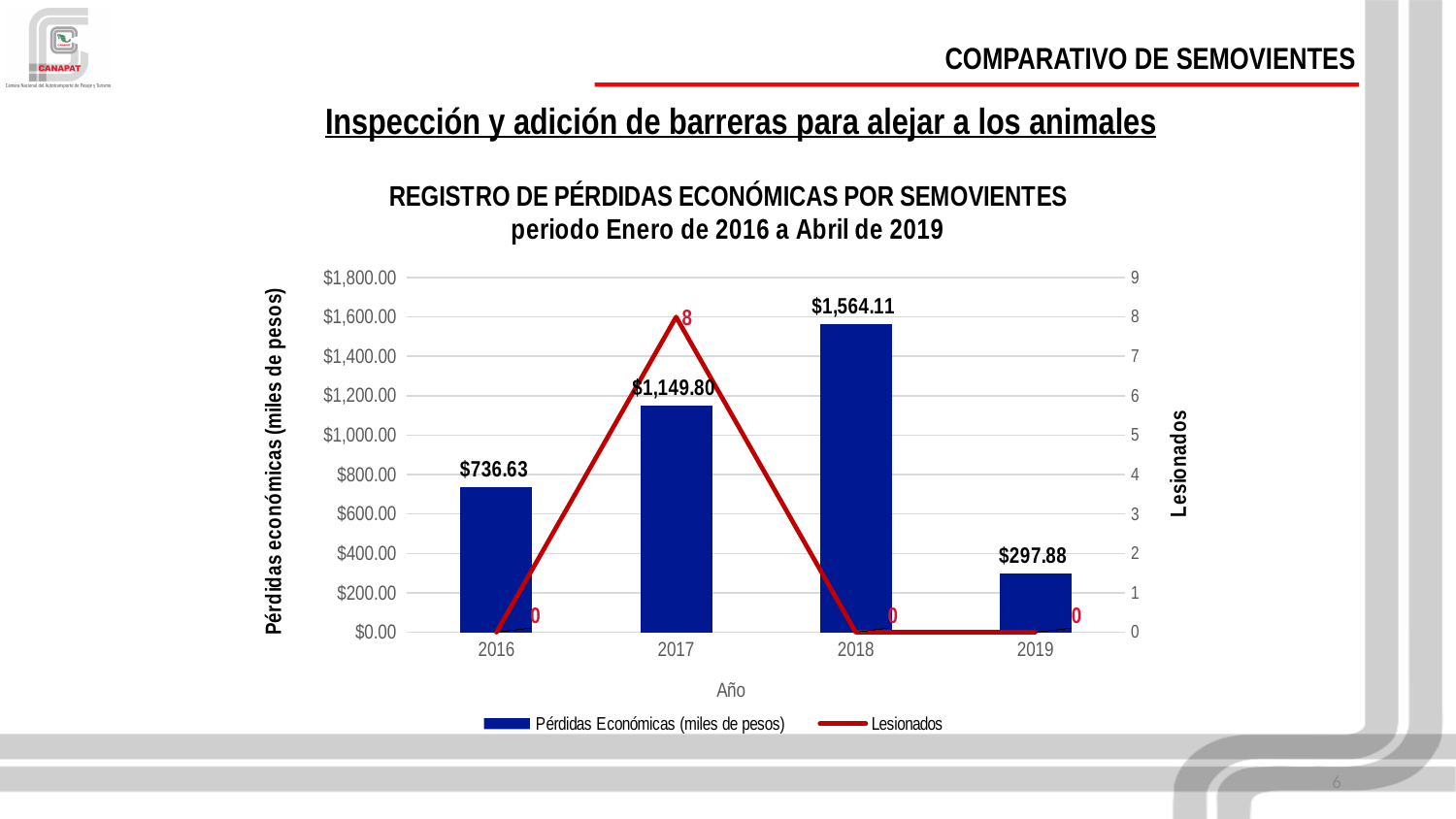
Which year has the highest Pérdidas Económicas? 2018 How many years are shown on the x axis? 4 Which year has larger Pérdidas Económicas, 2016 or 2017? 2017 What is the label of the right-hand vertical axis? Lesionados How many Lesionados are recorded for 2019? 0 What is the value of Pérdidas Económicas (miles de pesos) for 2018? $1,564.11 What is the value of Pérdidas Económicas (miles de pesos) for 2016? $736.63 What is the difference in Pérdidas Económicas between 2018 and 2017? $414.31 Which year has the lowest Pérdidas Económicas? 2019 How many series does the legend list? 2 What kind of chart is used for the Pérdidas Económicas series? Bar chart How many Lesionados are recorded for 2017? 8